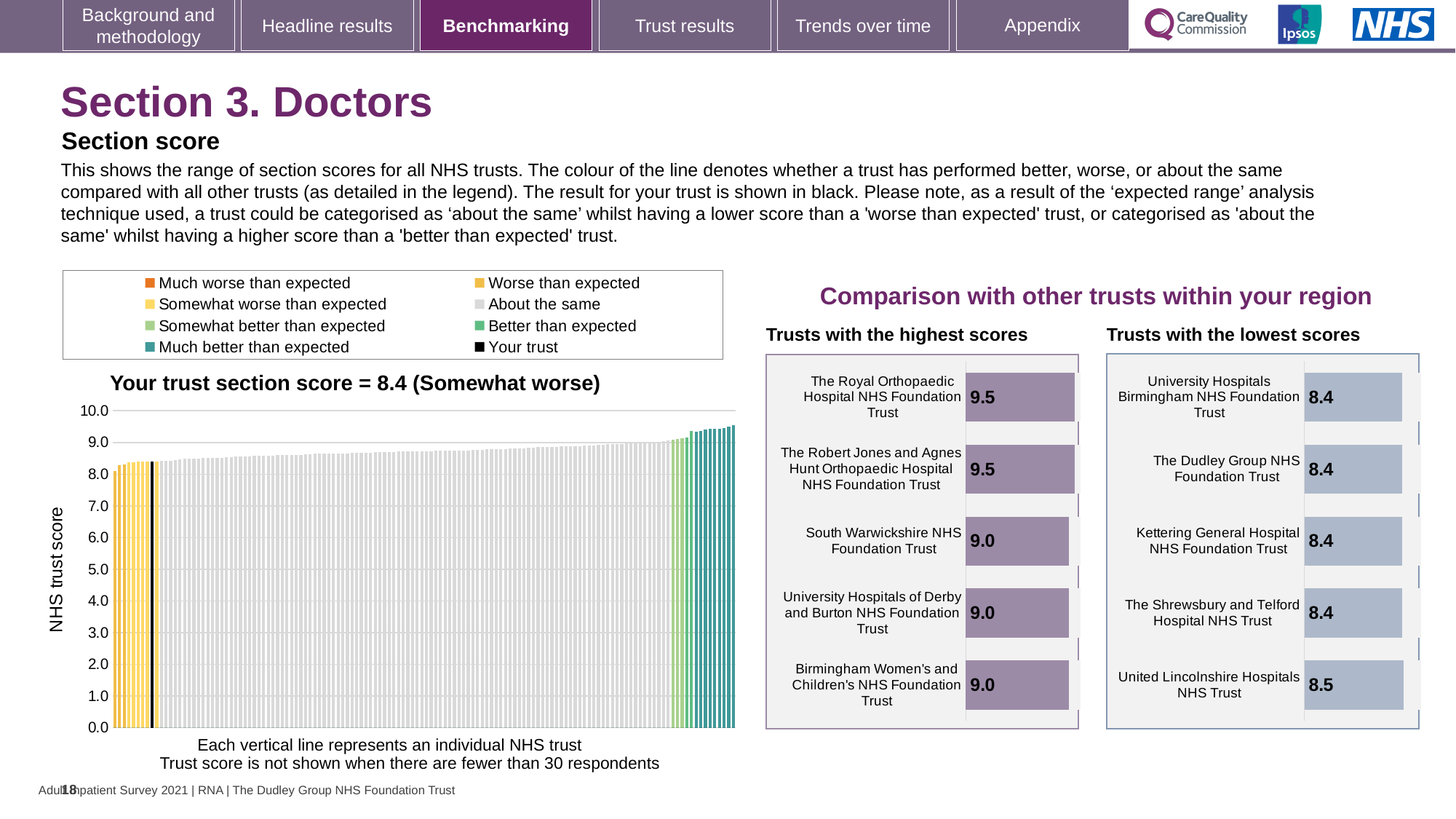
What kind of chart is the 'Trusts with the highest scores' chart? bar chart How many entries does the legend of the main chart on the left list? 8 In the 'Trusts with the lowest scores' chart, what is the difference between the scores of United Lincolnshire Hospitals NHS Trust and The Dudley Group NHS Foundation Trust? 0.1 In the 'Trusts with the highest scores' chart, what is the score for The Royal Orthopaedic Hospital NHS Foundation Trust? 9.5 In the 'Trusts with the highest scores' chart, which has the larger score: The Robert Jones and Agnes Hunt Orthopaedic Hospital NHS Foundation Trust or Birmingham Women's and Children's NHS Foundation Trust? The Robert Jones and Agnes Hunt Orthopaedic Hospital NHS Foundation Trust In the 'Trusts with the highest scores' chart, what is the difference between the scores of The Royal Orthopaedic Hospital NHS Foundation Trust and South Warwickshire NHS Foundation Trust? 0.5 In the main chart on the left, what is your trust's section score? 8.4 How many trusts are listed in the 'Trusts with the lowest scores' chart? 5 In the 'Trusts with the highest scores' chart, what is the score for South Warwickshire NHS Foundation Trust? 9.0 In the 'Trusts with the lowest scores' chart, what is the score for United Lincolnshire Hospitals NHS Trust? 8.5 In the 'Trusts with the lowest scores' chart, which trust has the highest score? United Lincolnshire Hospitals NHS Trust In the main chart on the left, do the trust scores rise or fall from left to right along the x axis? rise